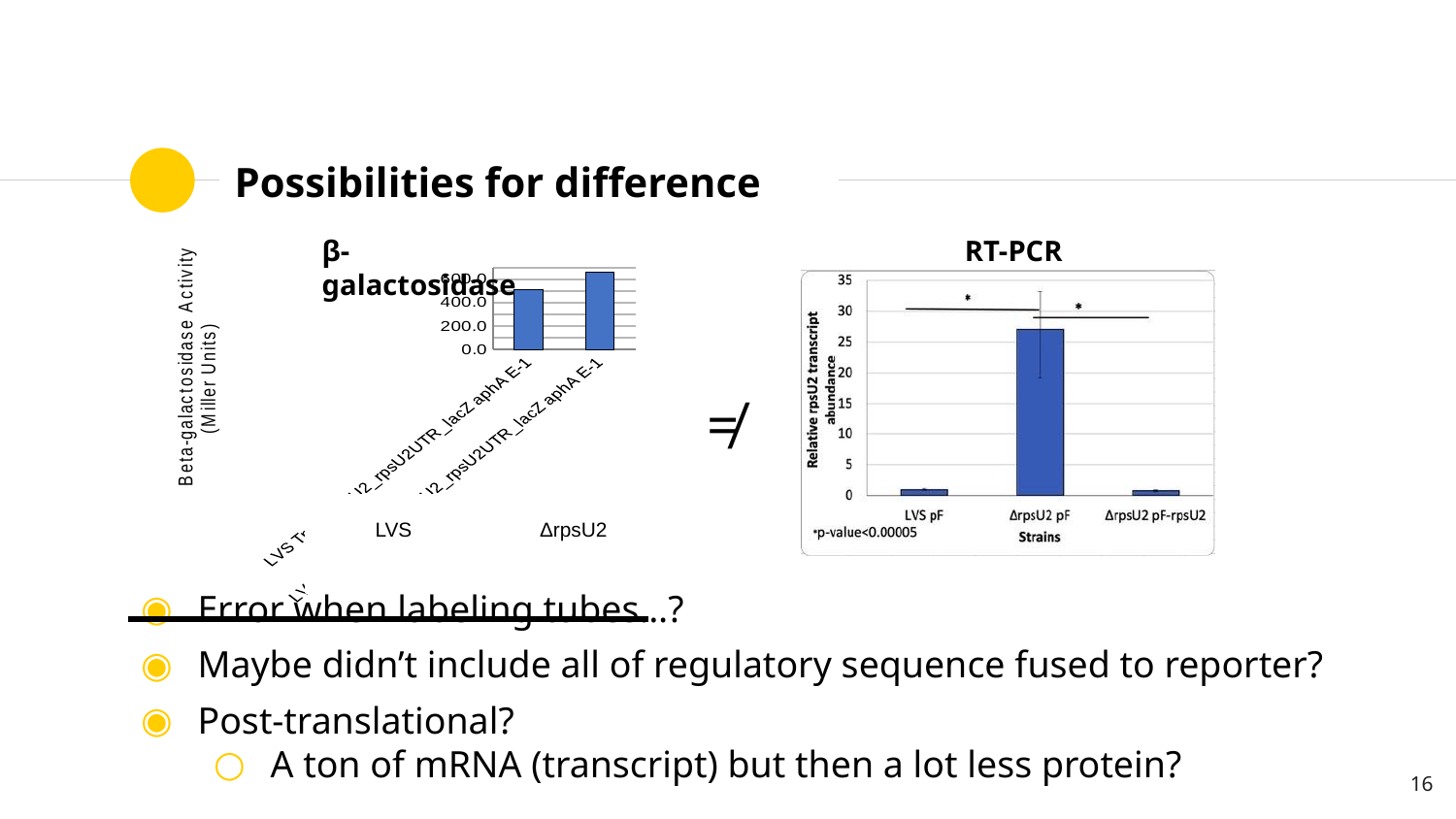
In the RT-PCR chart, is the value for LVS pF greater or less than 5? less What is the y-axis label of the RT-PCR chart? Relative rpsU2 transcript abundance In the β-galactosidase chart, which strain has the higher beta-galactosidase activity? ΔrpsU2 In the RT-PCR chart, which strain has the highest relative rpsU2 transcript abundance? ΔrpsU2 pF What is the x-axis title of the RT-PCR chart? Strains In the RT-PCR chart, is the value for ΔrpsU2 pF-rpsU2 greater or less than 5? less How many bars are shown in the β-galactosidase chart? 2 In the RT-PCR chart, is the value for ΔrpsU2 pF greater or less than 25? greater How many strains are plotted in the RT-PCR chart? 3 In the RT-PCR chart, which is larger: the value for LVS pF or the value for ΔrpsU2 pF? ΔrpsU2 pF What kind of chart is the RT-PCR chart? bar chart